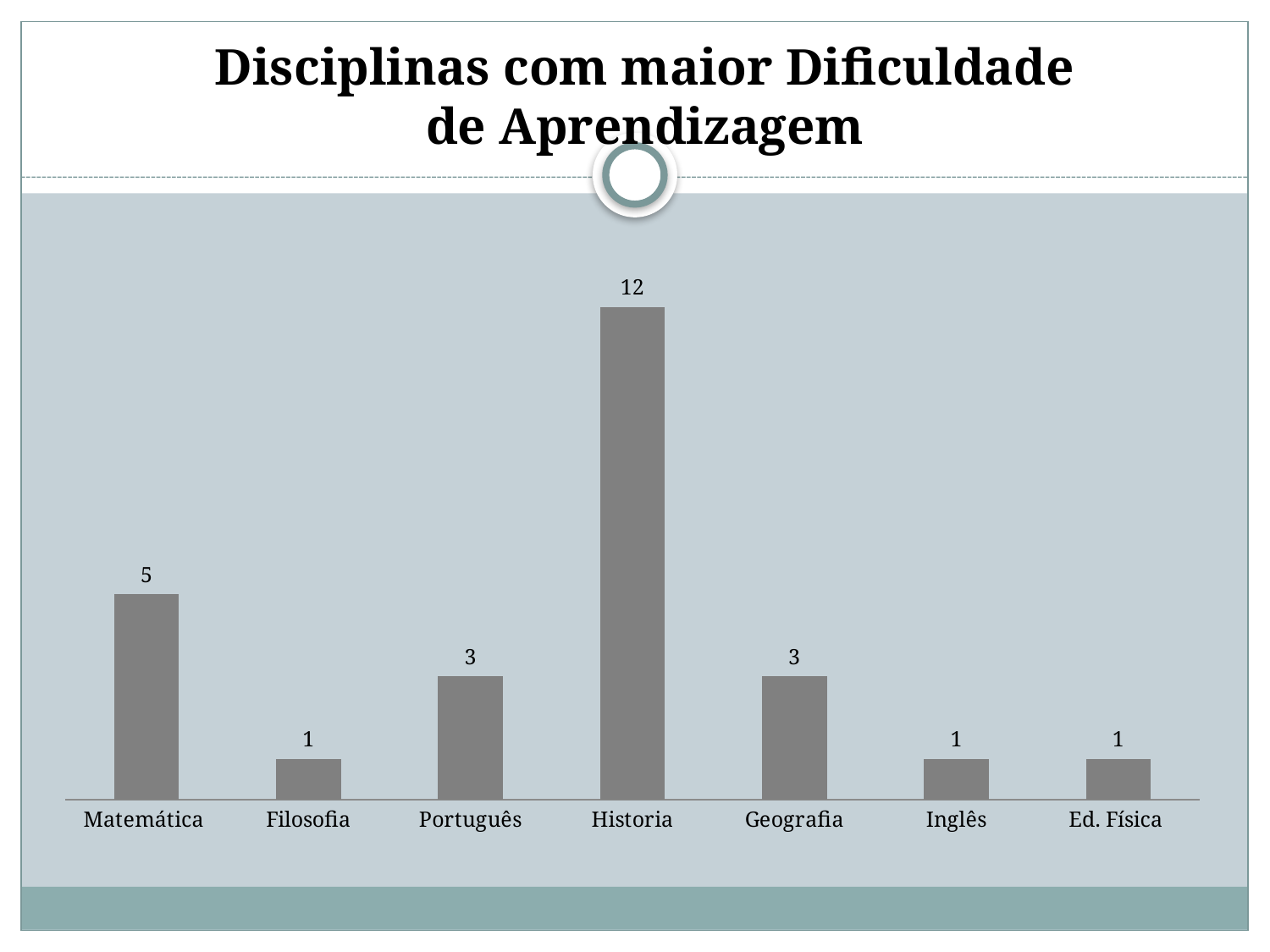
How many categories are shown on the x axis? 7 What is the value for Historia? 12 What is the value for Matemática? 5 What is the value for Inglês? 1 Which category has the highest value? Historia What is the difference between the values for Historia and Matemática? 7 What is the value for Geografia? 3 Which is larger, the value for Matemática or the value for Geografia? Matemática What is the difference between the values for Matemática and Português? 2 Which is larger, the value for Português or the value for Filosofia? Português What kind of chart is shown on the slide? Bar chart What is the title of the slide? Disciplinas com maior Dificuldade de Aprendizagem